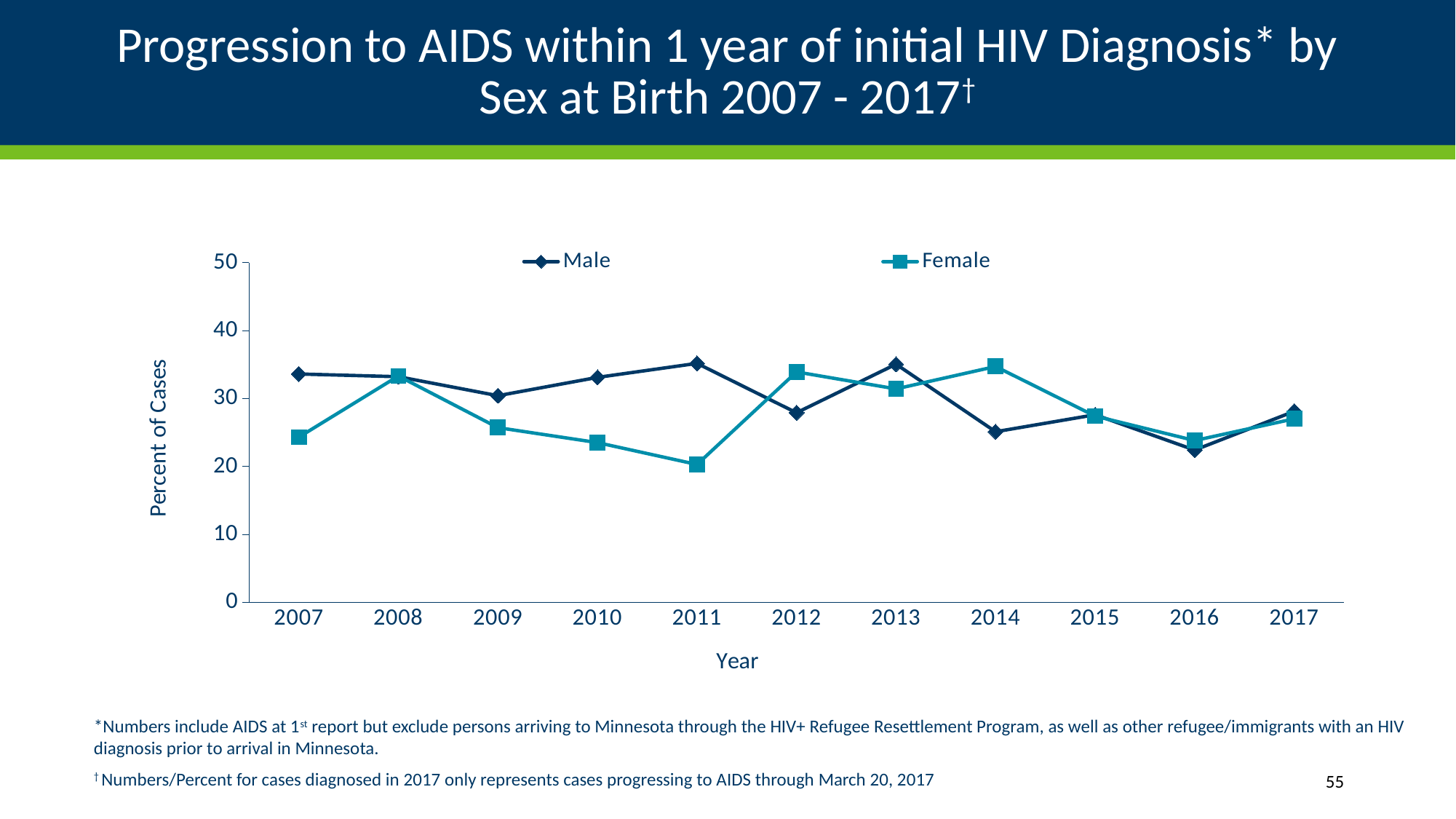
Is the value for Male in 2011 greater or less than 30? greater How many years are plotted along the x axis? 11 In 2014, which series has the larger value, Male or Female? Female Which year has the lowest value for the Male series? 2016 Which year has the lowest value for the Female series? 2011 What is the label on the vertical axis of the chart? Percent of Cases What kind of chart is shown on the slide? line chart Is the value for Female in 2007 greater or less than 30? less In 2007, which series has the larger value, Male or Female? Male Does the Female series rise or fall from 2008 to 2011? fall Is the value for Female in 2011 greater or less than 30? less How many series does the legend list? 2